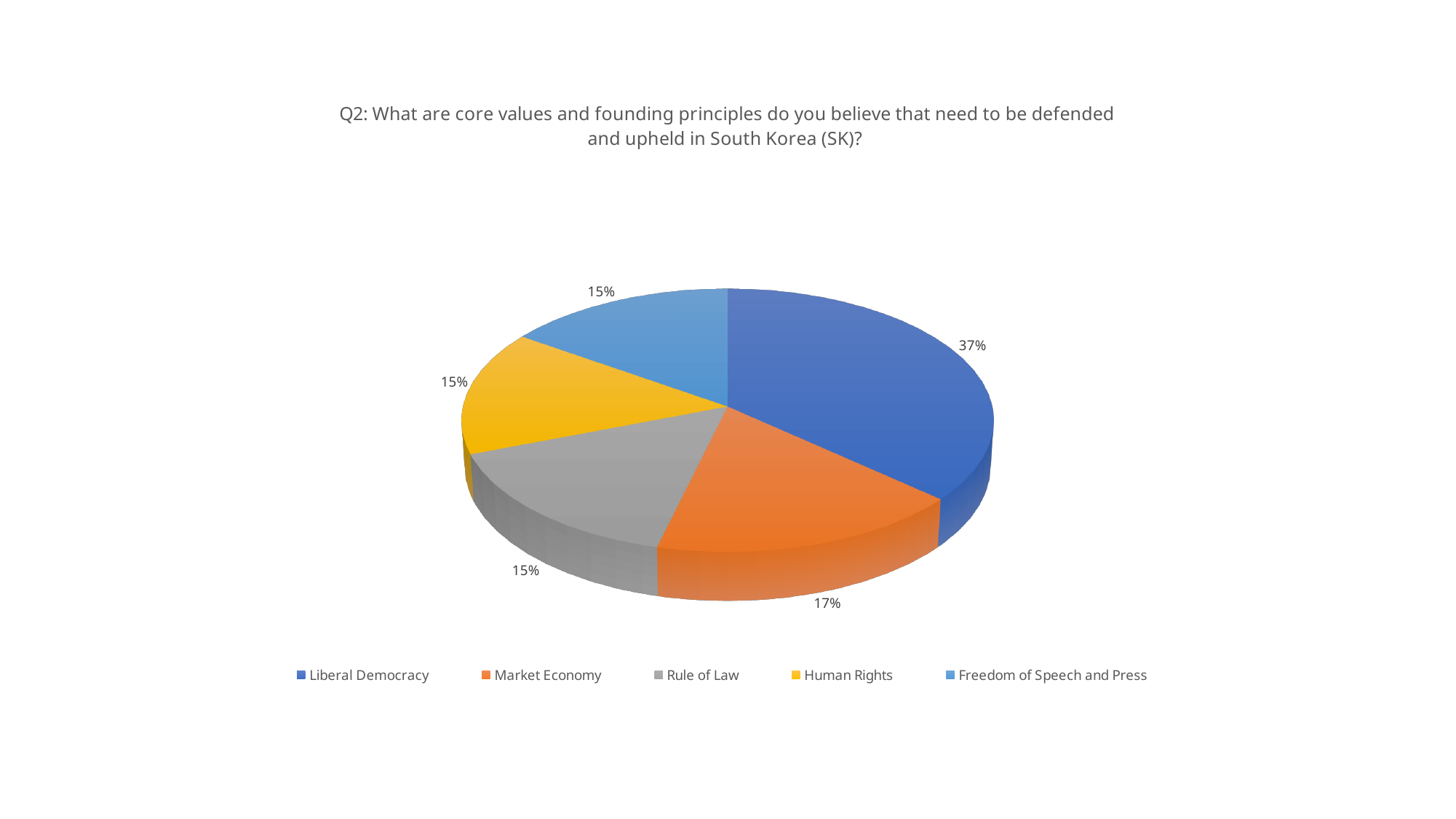
What is the combined share of Rule of Law and Human Rights? 30% Which category has the largest share of the pie? Liberal Democracy What is the difference in percentage points between Liberal Democracy and Market Economy? 20 What kind of chart is shown on the slide? Pie chart Which colour represents Human Rights in the legend? Yellow What percentage of the pie is Rule of Law? 15% What percentage of the pie is Freedom of Speech and Press? 15% Which is larger, Market Economy or Human Rights? Market Economy How many categories does the pie chart show? 5 What percentage of the pie is Liberal Democracy? 37% What percentage of the pie is Market Economy? 17% How many categories share the value 15%? 3